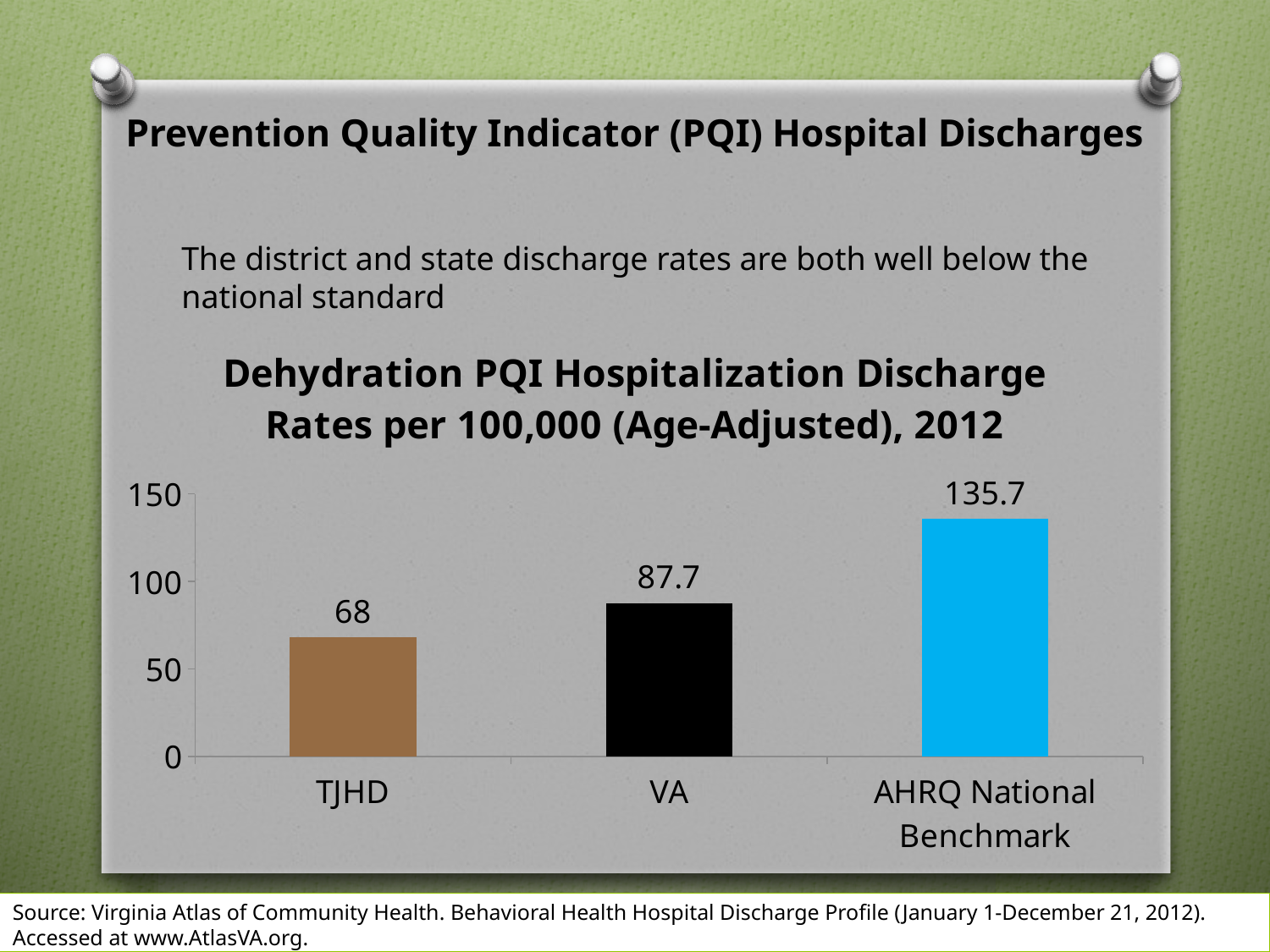
Which is larger, the rate for VA or the rate for TJHD? VA How many categories are shown on the chart? 3 What is the dehydration PQI hospitalization discharge rate for VA? 87.7 What is the dehydration PQI hospitalization discharge rate for TJHD? 68 What is the title of the chart? Dehydration PQI Hospitalization Discharge Rates per 100,000 (Age-Adjusted), 2012 What kind of chart is shown on the slide? Bar chart Which category has the lowest discharge rate? TJHD Which category has the highest discharge rate? AHRQ National Benchmark What is the difference between the AHRQ National Benchmark rate and the VA rate? 48 What is the value shown for the AHRQ National Benchmark? 135.7 Is the value for TJHD greater or less than 100? less What is the difference between the VA rate and the TJHD rate? 19.7